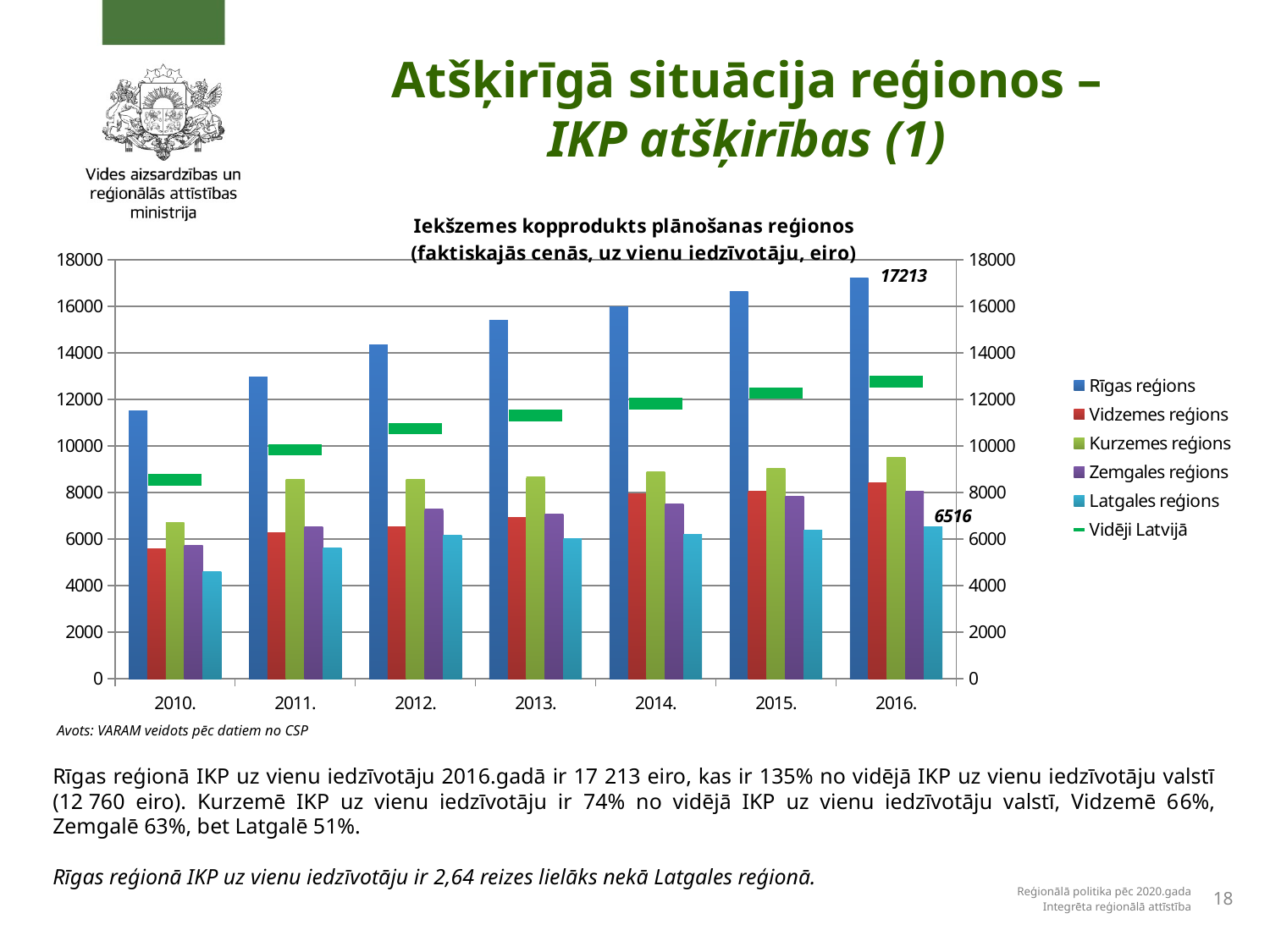
Do the values for Rīgas reģions rise or fall from 2010 to 2016? rise What is the value for Latgales reģions in 2016? 6516 How many series does the legend list? 6 How many years are shown on the x axis of the chart? 7 Is the value for Latgales reģions in 2010 greater or less than 6000? less What kind of chart is shown on the slide? combination bar and line chart Is the value for Vidēji Latvijā in 2016 greater or less than 12000? greater In 2014, which is larger: the value for Kurzemes reģions or Vidzemes reģions? Kurzemes reģions Which region has the lowest value in 2010? Latgales reģions Which region has the highest value in 2016? Rīgas reģions What is the value for Rīgas reģions in 2016? 17213 What is the difference between the 2016 values for Rīgas reģions and Latgales reģions? 10697